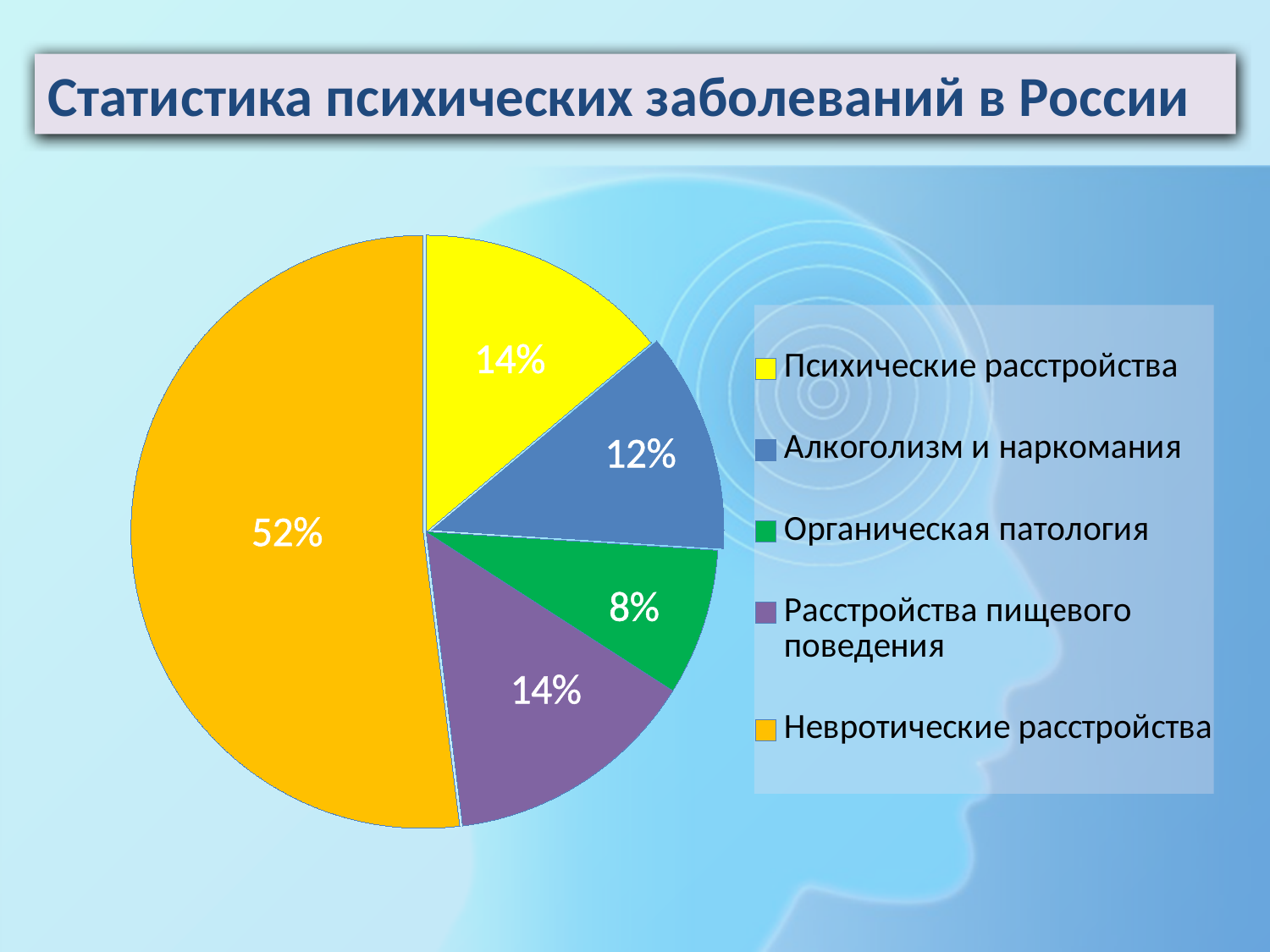
How many categories are shown in the pie chart? 5 What is the value shown for Органическая патология? 8% Which category has the smallest slice of the pie? Органическая патология What is the value shown for Алкоголизм и наркомания? 12% What is the difference in percentage points between Невротические расстройства and Психические расстройства? 38 What kind of chart is shown on the slide? Pie chart What is the title of the slide? Статистика психических заболеваний в России What colour is the slice for Органическая патология? Green Which category has the largest slice of the pie? Невротические расстройства What is the value shown for Расстройства пищевого поведения? 14% What share of the pie does Невротические расстройства take? 52% Which is larger: the slice for Алкоголизм и наркомания or the slice for Органическая патология? Алкоголизм и наркомания